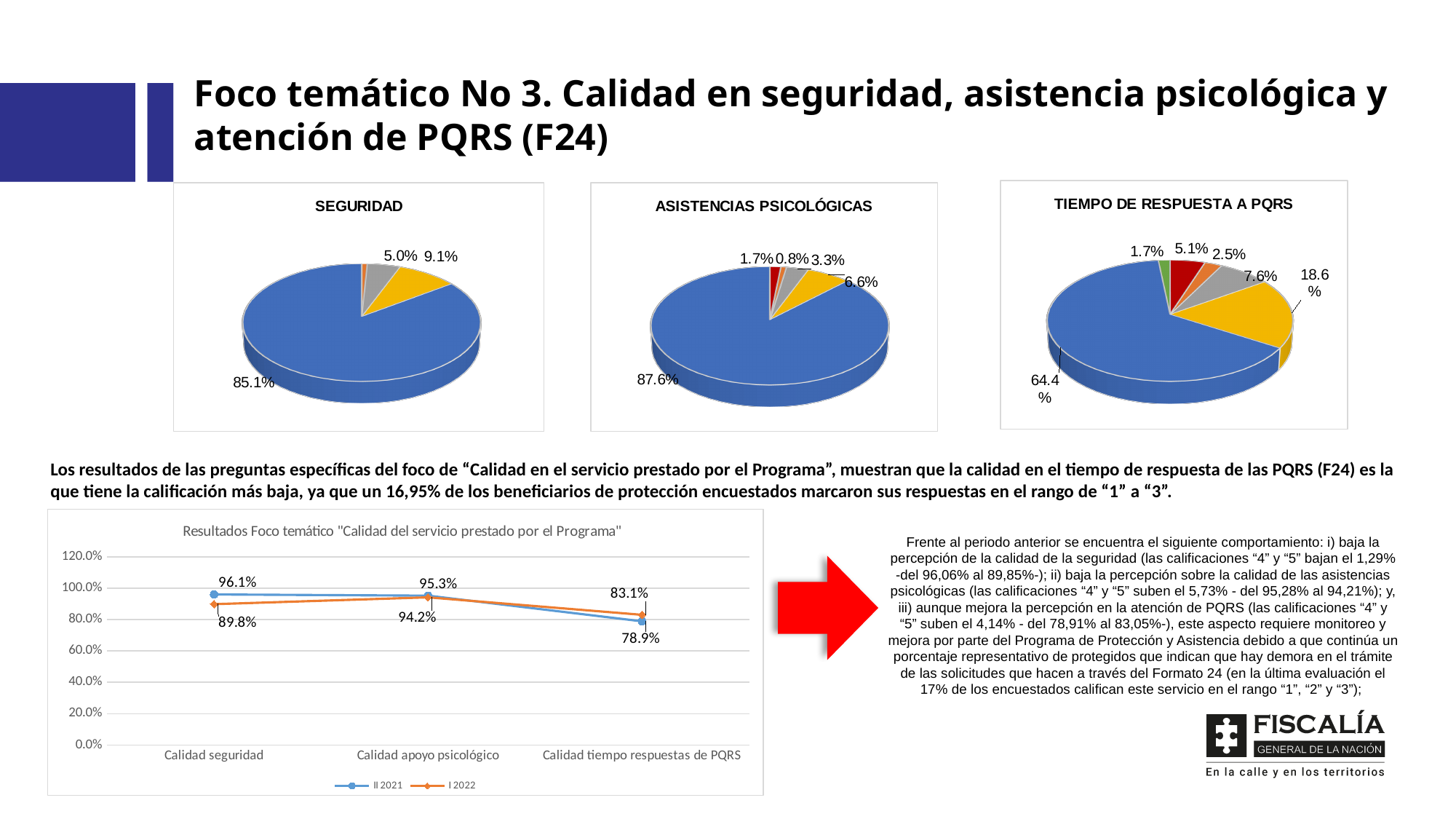
In the SEGURIDAD chart, what is the value of the largest slice? 85.1% How many slices does the TIEMPO DE RESPUESTA A PQRS pie chart have? 6 In the TIEMPO DE RESPUESTA A PQRS chart, what is the value of the largest slice? 64.4% In the line chart at the bottom left, what is the I 2022 value for Calidad tiempo respuestas de PQRS? 83.1% In the line chart at the bottom left, which category has the lowest II 2021 value? Calidad tiempo respuestas de PQRS In the ASISTENCIAS PSICOLÓGICAS chart, what is the value of the smallest slice? 0.8% What kind of chart is the SEGURIDAD chart? Pie chart In the line chart at the bottom left, what is the difference between the II 2021 and I 2022 values for Calidad seguridad? 6.3% In the line chart at the bottom left, what is the II 2021 value for Calidad seguridad? 96.1% In the line chart at the bottom left, how many series does the legend list? 2 In the line chart at the bottom left, which series has the larger value for Calidad tiempo respuestas de PQRS, II 2021 or I 2022? I 2022 In the line chart at the bottom left, how many categories are shown on the x axis? 3